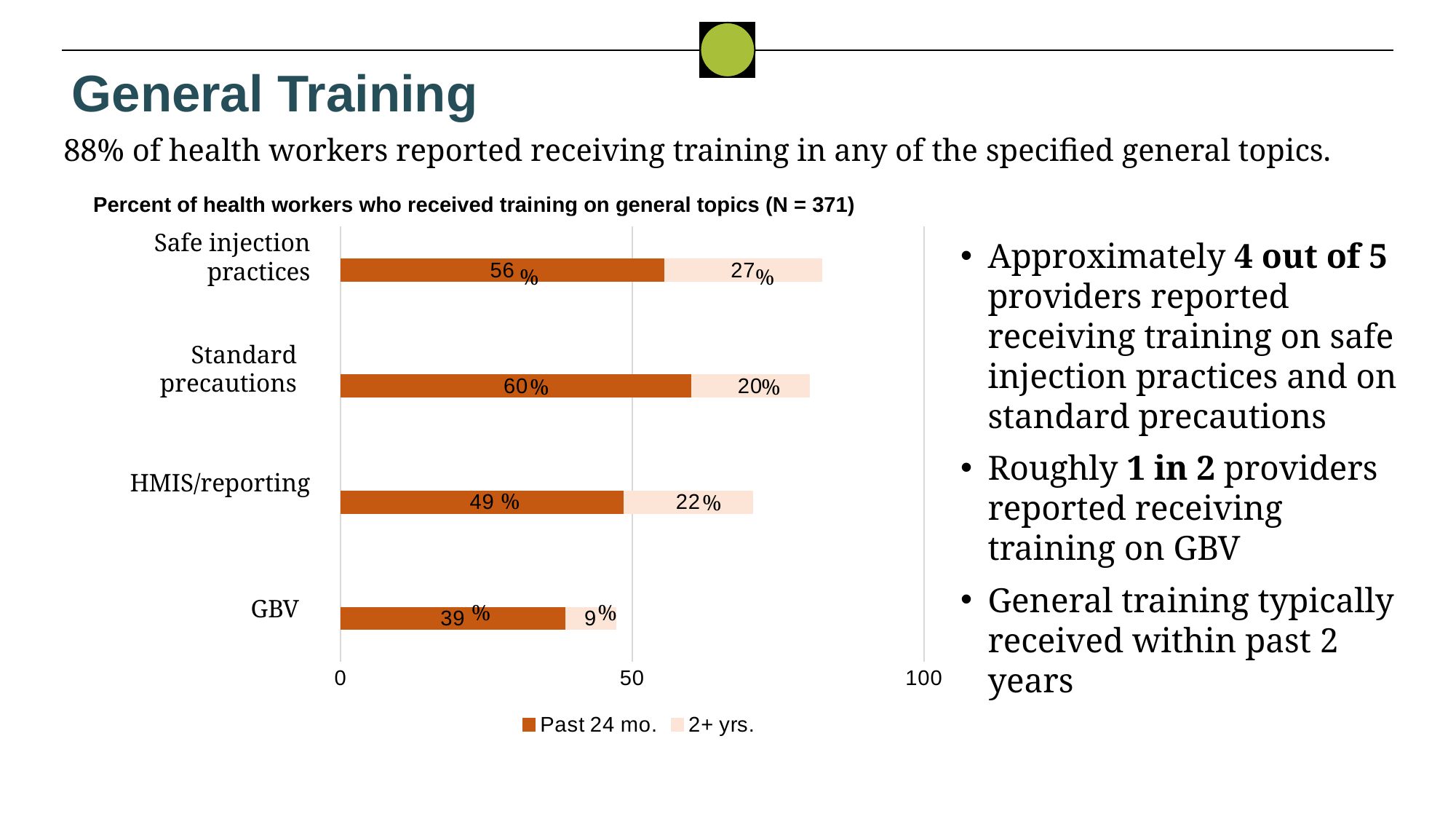
What is the total of the stacked bar for GBV? 48% What is the 'Past 24 mo.' value for GBV? 39% How many topics (categories) are shown in the chart? 4 What is the total of the stacked bar for Safe injection practices? 83% Which is larger: the '2+ yrs.' value for HMIS/reporting or for Standard precautions? HMIS/reporting What is the difference between the 'Past 24 mo.' values for Standard precautions and HMIS/reporting? 11% What type of chart is shown on the slide? Stacked bar chart Which topic has the lowest '2+ yrs.' value? GBV What is the '2+ yrs.' value for Safe injection practices? 27% Which topic has the highest 'Past 24 mo.' value? Standard precautions How many series does the legend list? 2 What percentage of health workers received training on Standard precautions in the past 24 months? 60%